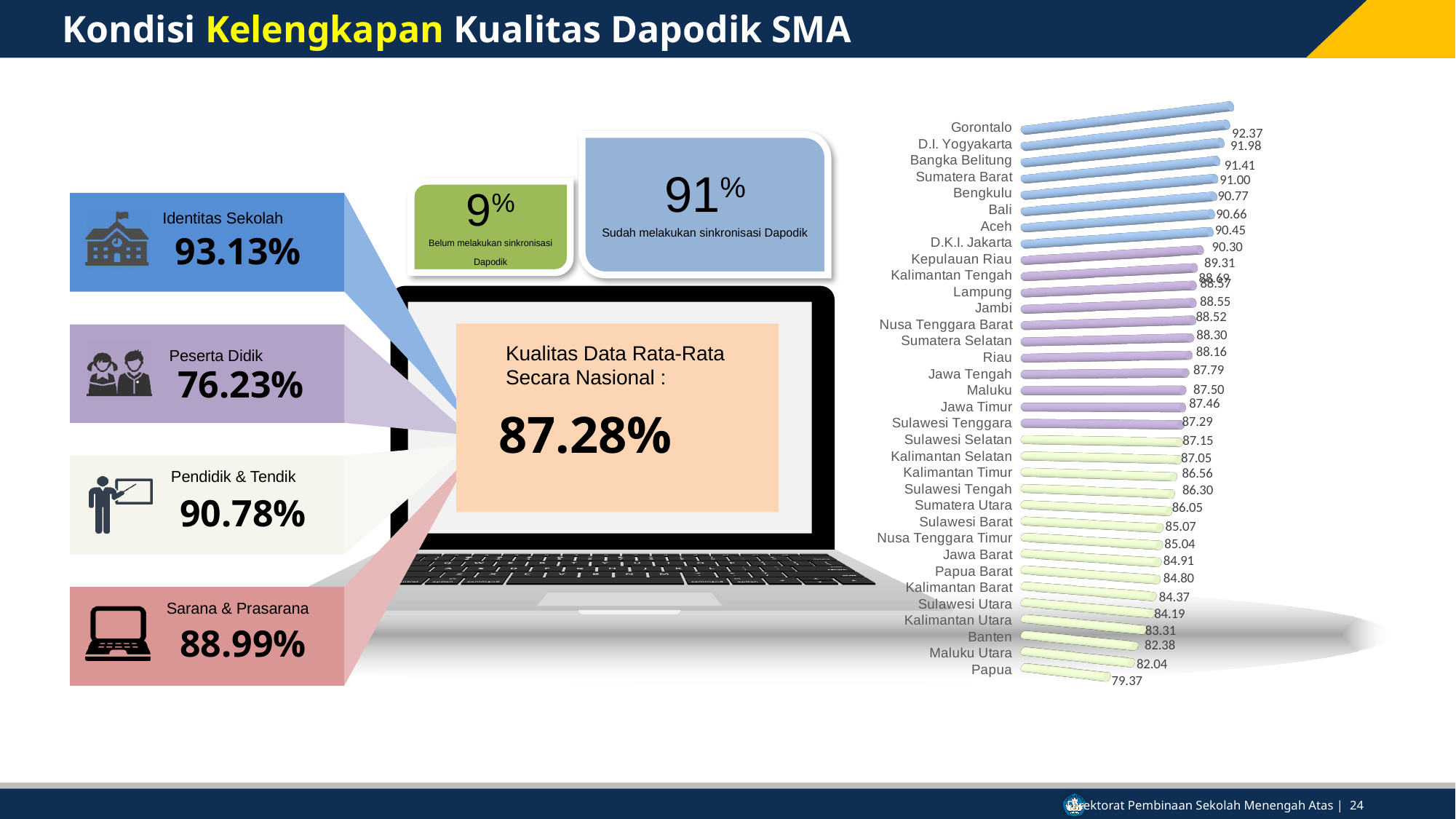
What is the value for Gorontalo in the province bar chart? 92.37 What is the difference between the values for Gorontalo and Papua in the bar chart? 13.00 What kind of chart is used to show the province values? Bar chart What is the value for Jawa Tengah in the province bar chart? 87.79 How many provinces are listed in the bar chart? 34 Which province has the lowest value in the bar chart? Papua What is the value for Papua in the province bar chart? 79.37 Which province has the highest value in the bar chart? Gorontalo Do the values in the province bar chart increase or decrease from top to bottom? Decrease Which has a larger value in the bar chart, Sumatera Utara or Sulawesi Barat? Sumatera Utara What is the difference between the values for Bali and Aceh in the bar chart? 0.21 What is the value for Banten in the province bar chart? 82.38